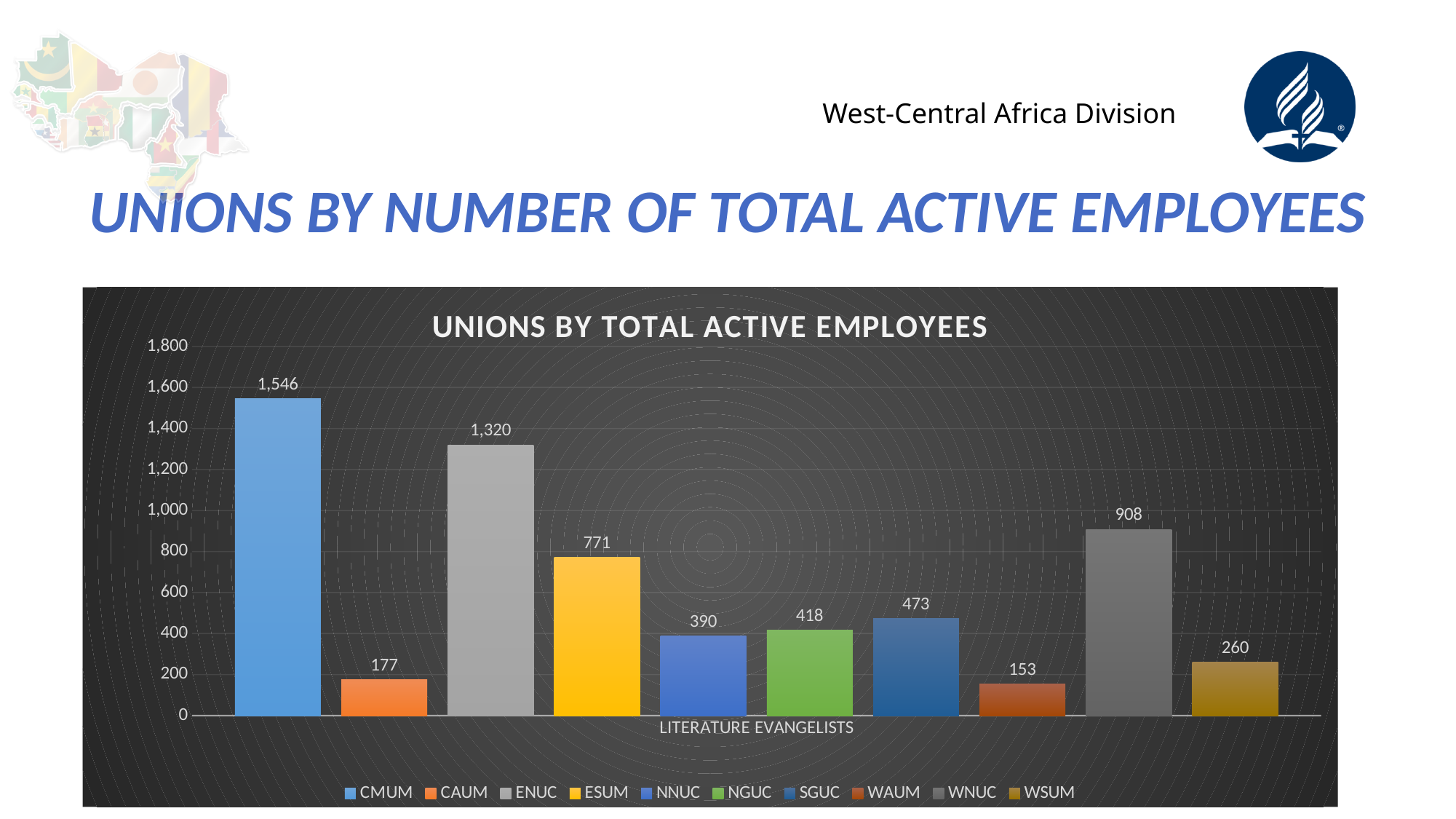
What is the value for NGUC? 418 What is the difference between the values for CMUM and ENUC? 226 What kind of chart is shown on the slide? Bar chart Which union has the highest number of total active employees? CMUM What is the title of the chart? UNIONS BY TOTAL ACTIVE EMPLOYEES What is the difference between the values for WNUC and ESUM? 137 What is the value for WNUC? 908 How many unions are shown in the chart? 10 Is the value for ESUM greater or less than 600? greater What is the value for CMUM? 1,546 Which is larger, the value for SGUC or the value for NNUC? SGUC Which union has the lowest number of total active employees? WAUM